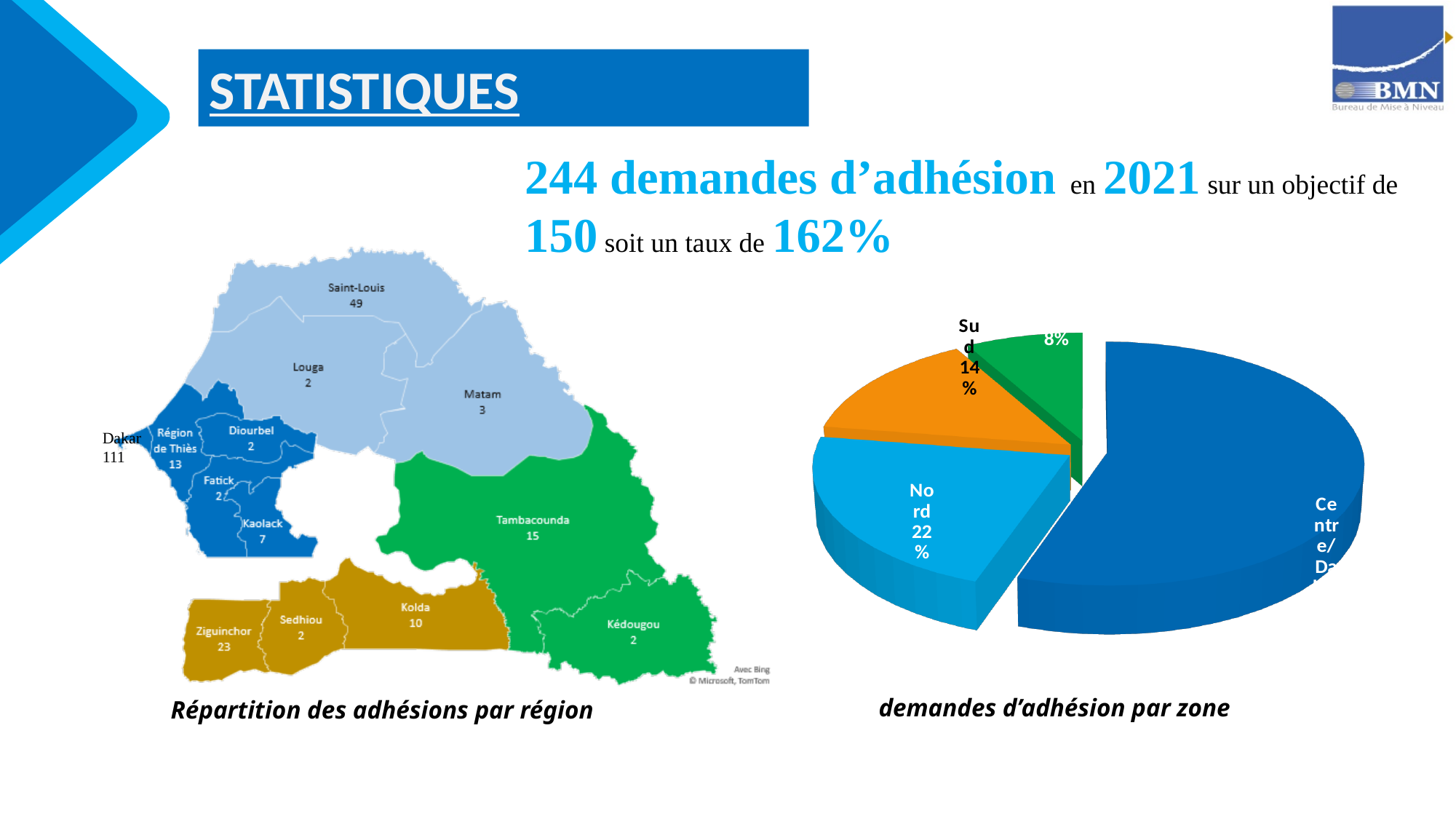
In the map chart 'Répartition des adhésions par région', what is the value for Dakar? 111 In the pie chart 'demandes d'adhésion par zone', what share does the Sud slice have? 14% In the map chart 'Répartition des adhésions par région', how many regions are labelled with a value? 13 In the map chart 'Répartition des adhésions par région', which has the larger value, Kolda or Kaolack? Kolda In the map chart 'Répartition des adhésions par région', what is the value for Ziguinchor? 23 In the pie chart 'demandes d'adhésion par zone', what share does the Nord slice have? 22% In the map chart 'Répartition des adhésions par région', which region has the highest value? Dakar In the pie chart 'demandes d'adhésion par zone', which slice is larger, Nord or Sud? Nord What kind of chart is 'demandes d'adhésion par zone'? Pie chart In the map chart 'Répartition des adhésions par région', what is the value for Saint-Louis? 49 In the map chart 'Répartition des adhésions par région', what is the difference between the values for Dakar and Saint-Louis? 62 In the map chart 'Répartition des adhésions par région', what is the value for Tambacounda? 15